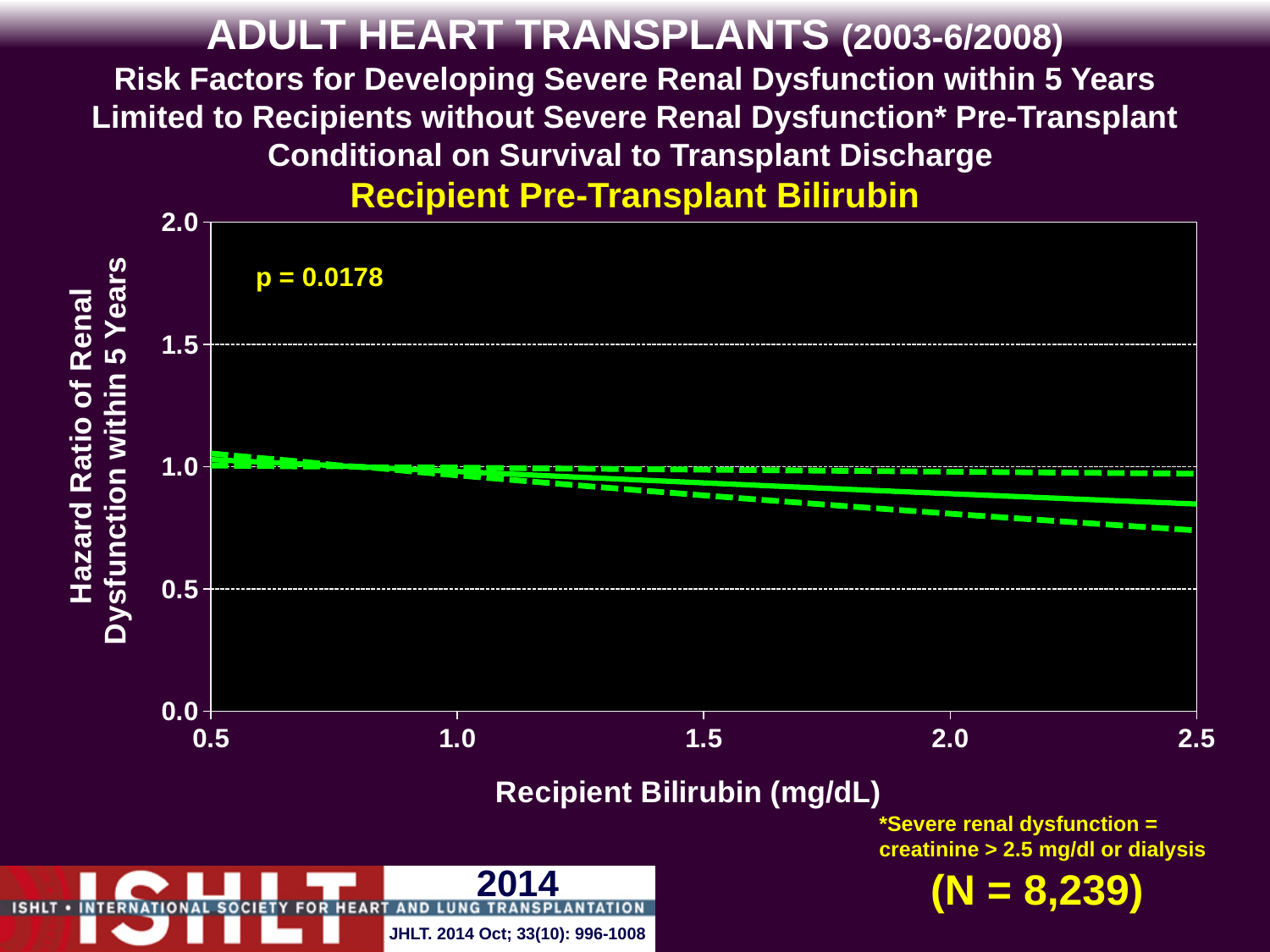
What is the p-value shown on the chart? p = 0.0178 What kind of chart is shown on the slide? line chart What is the sample size (N) shown on the slide? N = 8,239 Does the hazard ratio rise or fall as recipient bilirubin increases from 0.5 to 2.5 mg/dL? fall What is the highest recipient bilirubin value labelled on the x axis? 2.5 Is the lower dashed confidence line at a recipient bilirubin of 2.5 mg/dL greater or less than 1.0? less How many tick labels are shown on the x axis? 5 Is the hazard ratio on the solid line at a recipient bilirubin of 1.5 mg/dL greater or less than 1.5? less Is the hazard ratio on the solid line at a recipient bilirubin of 2.5 mg/dL greater or less than 0.5? greater What is the maximum value labelled on the y axis? 2.0